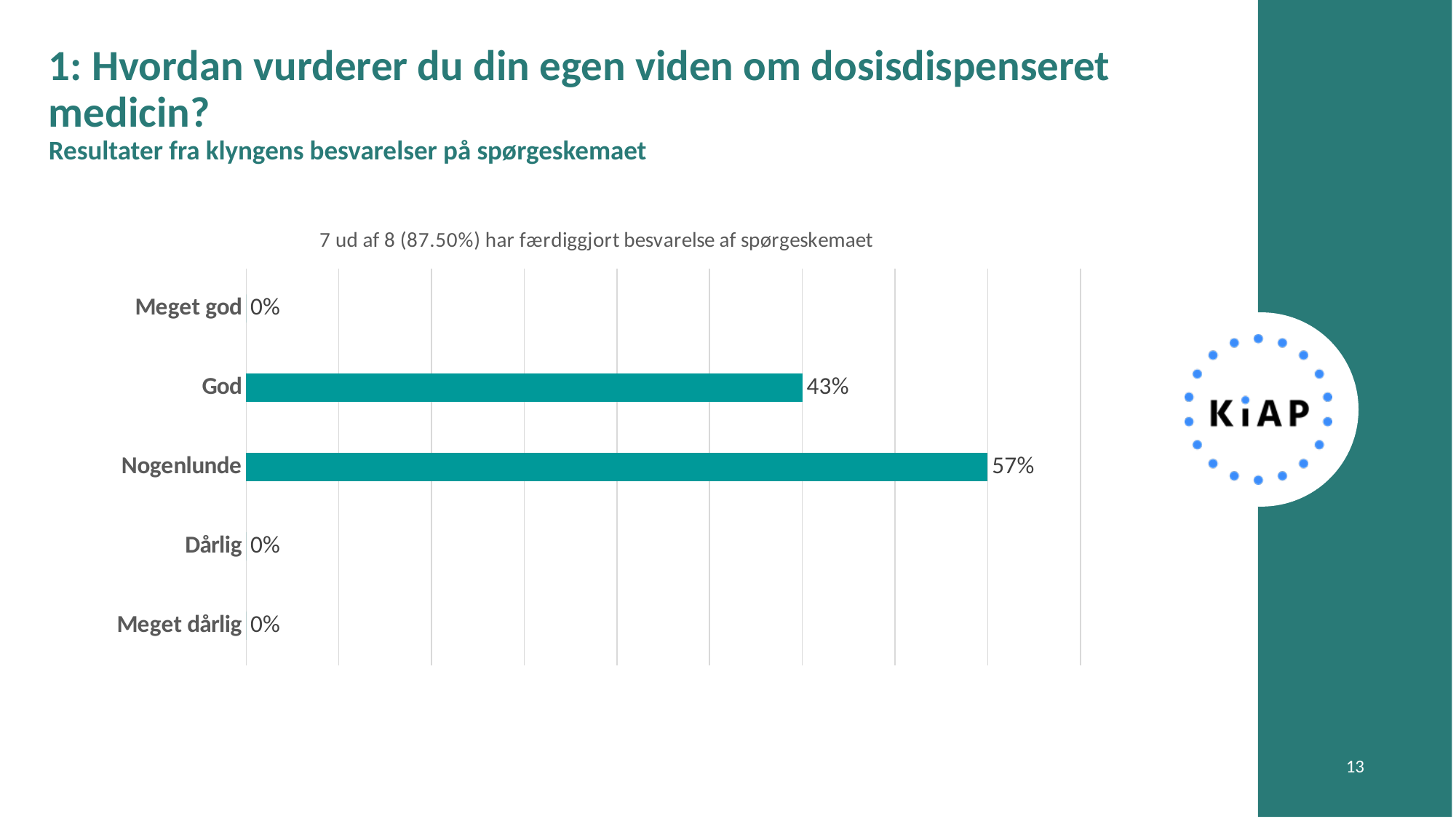
Which is larger, the value for God or the value for Nogenlunde? Nogenlunde What is the value for Meget god? 0% What is the difference between the values for Nogenlunde and God? 14% What is the value for Nogenlunde? 57% What is the chart's title? 7 ud af 8 (87.50%) har færdiggjort besvarelse af spørgeskemaet What is the total of the values for God and Nogenlunde? 100% What is the value for Dårlig? 0% What kind of chart is shown on the slide? Bar chart How many categories have a value of 0%? 3 What is the value for God? 43% How many categories are shown in the chart? 5 Which category has the highest value? Nogenlunde